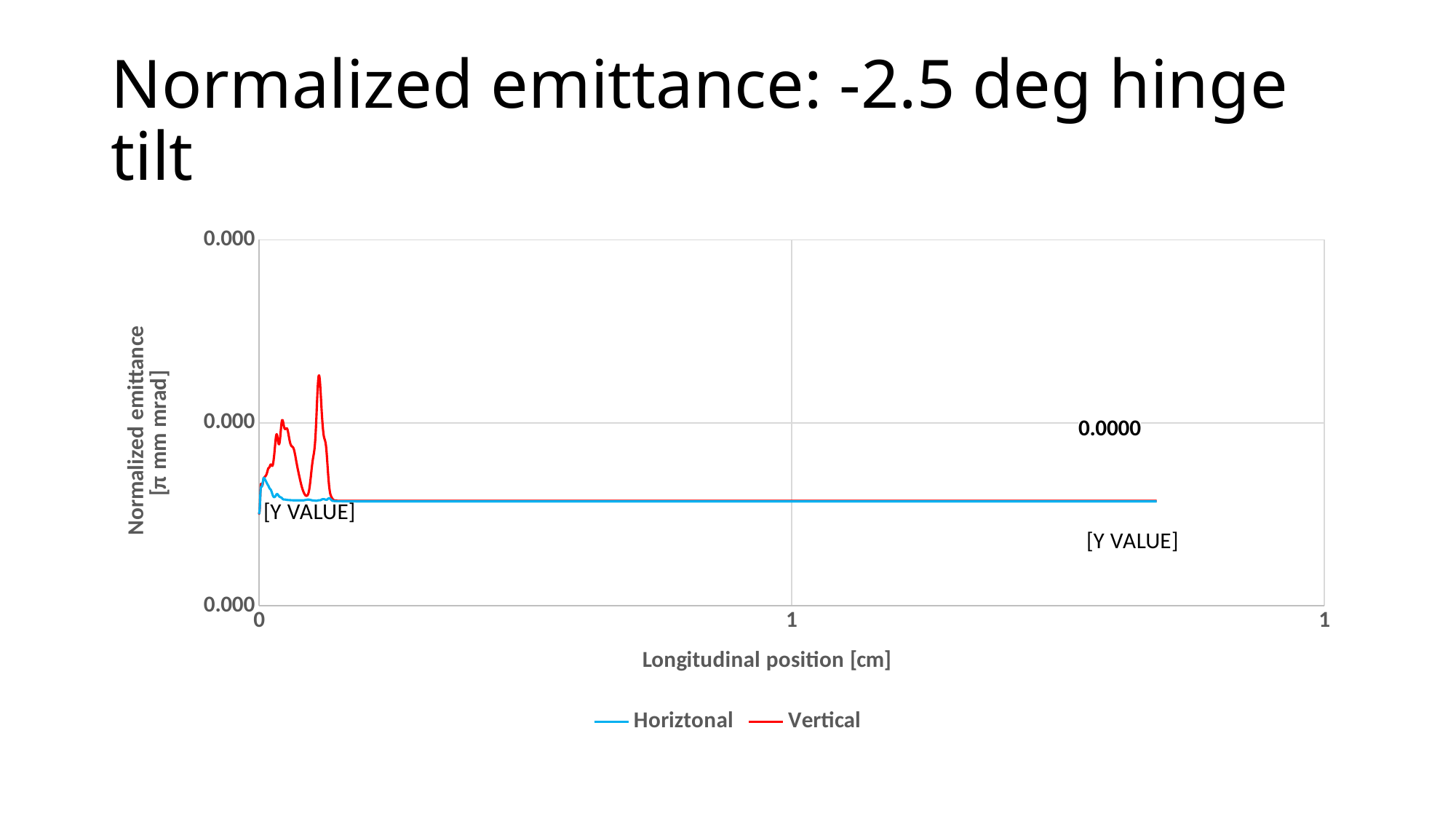
After the initial peaks near the left of the x axis, do the lines keep rising, keep falling, or stay flat? Stay flat What colour is the Vertical series line? Red Which series shows the large spikes near the start of the x axis? Vertical What kind of chart is shown on the slide? Line chart How many series does the legend list? 2 Which series reaches the higher peak, Horiztonal or Vertical? Vertical What is the title of the x axis? Longitudinal position [cm]